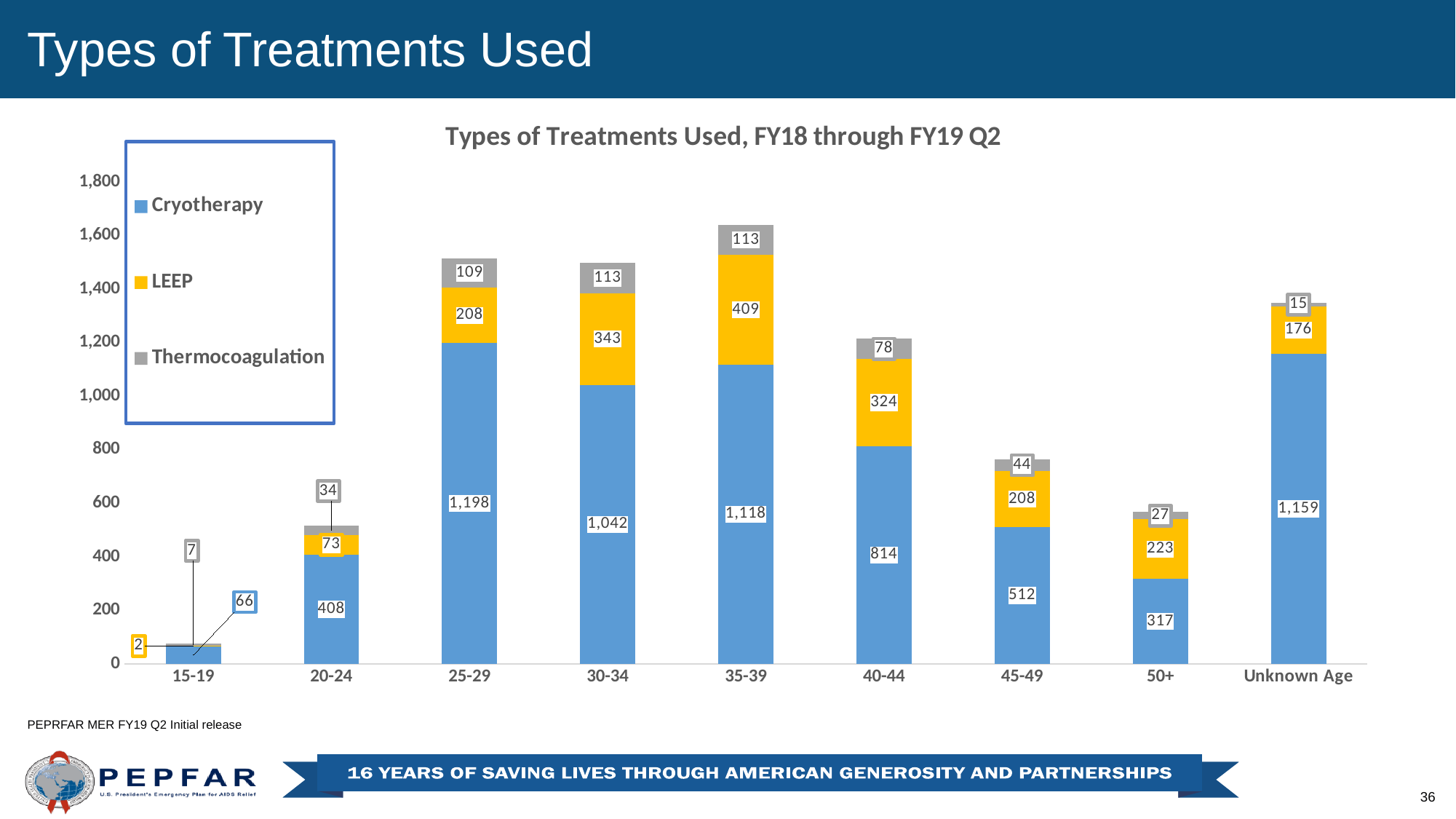
What kind of chart is shown on the slide? Stacked bar chart What is the Cryotherapy value for the Unknown Age group? 1,159 What is the total of the stacked bar for the 35-39 age group? 1,640 What is the LEEP value for the 35-39 age group? 409 What is the difference between the Cryotherapy values for the 25-29 and 30-34 age groups? 156 Which age group has the lowest LEEP value? 15-19 What is the Thermocoagulation value for the 20-24 age group? 34 How many series does the legend list? 3 Which has a larger Cryotherapy value, the 40-44 or the 45-49 age group? 40-44 Which age group has the highest Cryotherapy value? 25-29 How many age groups are shown on the x axis? 9 What is the Cryotherapy value for the 25-29 age group? 1,198